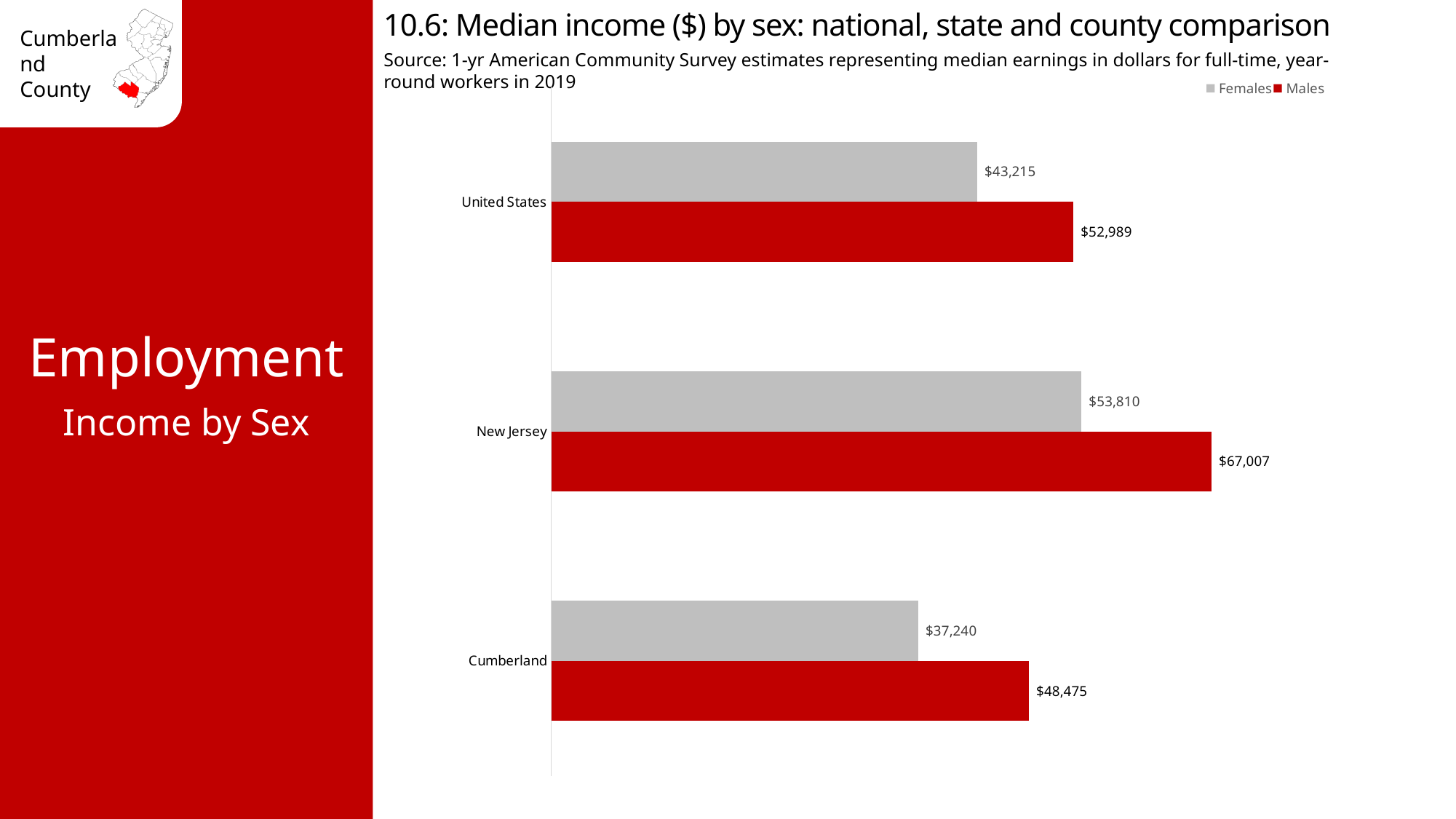
How many series does the legend list? 2 What kind of chart is shown on the slide? Bar chart What is the median income for Females in the United States? $43,215 Which is larger: the Females median income in New Jersey or the Males median income in the United States? Females median income in New Jersey What is the median income for Males in Cumberland? $48,475 What is the difference between the Males and Females median income in Cumberland? $11,235 How many categories are shown on the chart? 3 What is the difference between the Males and Females median income in New Jersey? $13,197 What is the median income for Females in Cumberland? $37,240 Which category has the lowest median income for Females? Cumberland What is the median income for Males in New Jersey? $67,007 Which category has the highest median income for Males? New Jersey